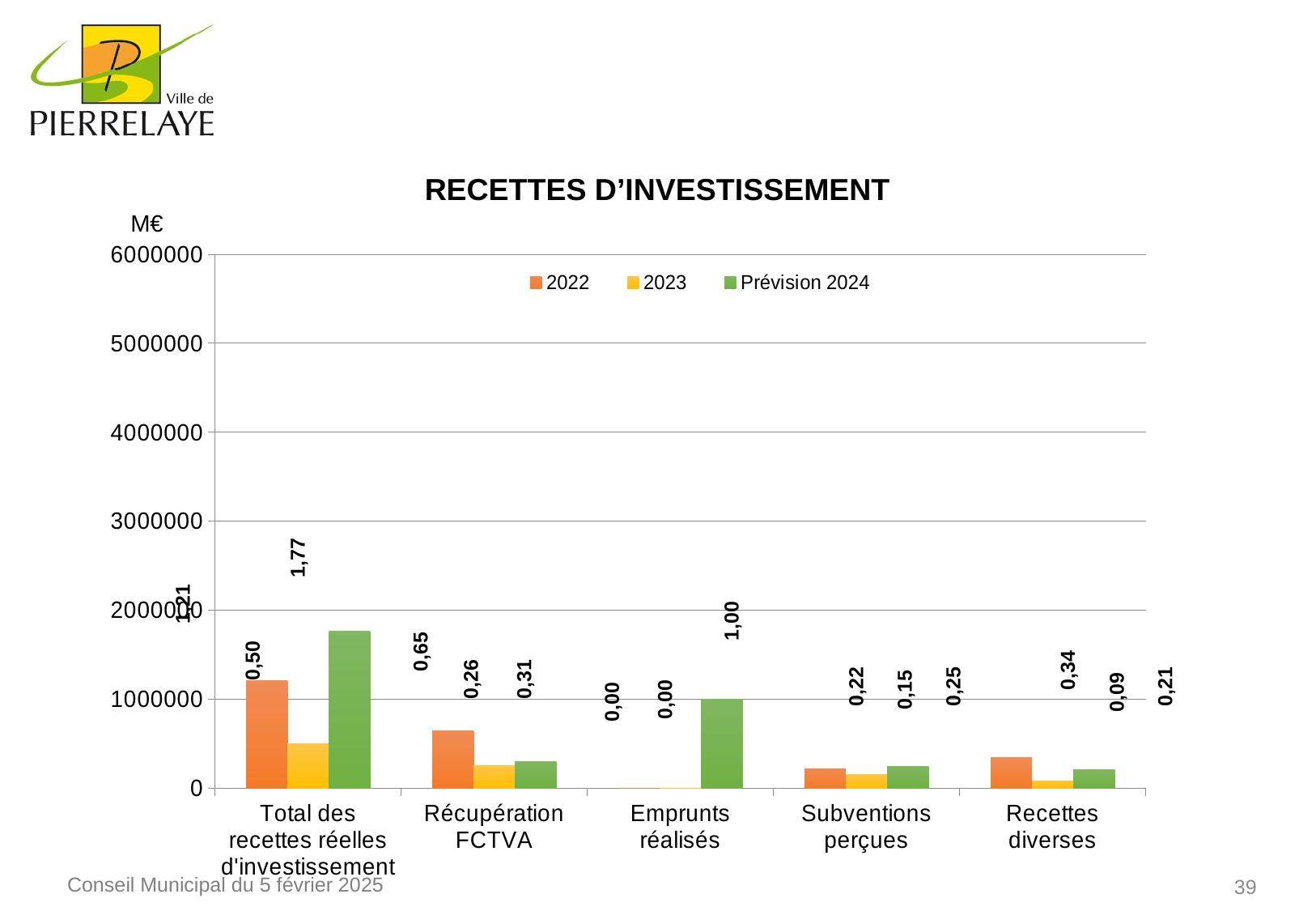
What is the difference between the 2022 and 2023 values for Récupération FCTVA? 0,39 How many categories are shown on the x axis? 5 Which category has the highest Prévision 2024 value? Total des recettes réelles d'investissement What is the 2023 value for Récupération FCTVA? 0,26 What kind of chart is shown on the slide? Bar chart Which category has the lowest 2022 value? Emprunts réalisés What is the 2022 value for Recettes diverses? 0,34 Is the 2022 bar for Total des recettes réelles d'investissement greater or less than 1000000 on the axis? greater Which is larger for Subventions perçues: the 2022 value or the Prévision 2024 value? Prévision 2024 What is the Prévision 2024 value for Total des recettes réelles d'investissement? 1,77 What is the Prévision 2024 value for Emprunts réalisés? 1,00 How many series does the legend list? 3